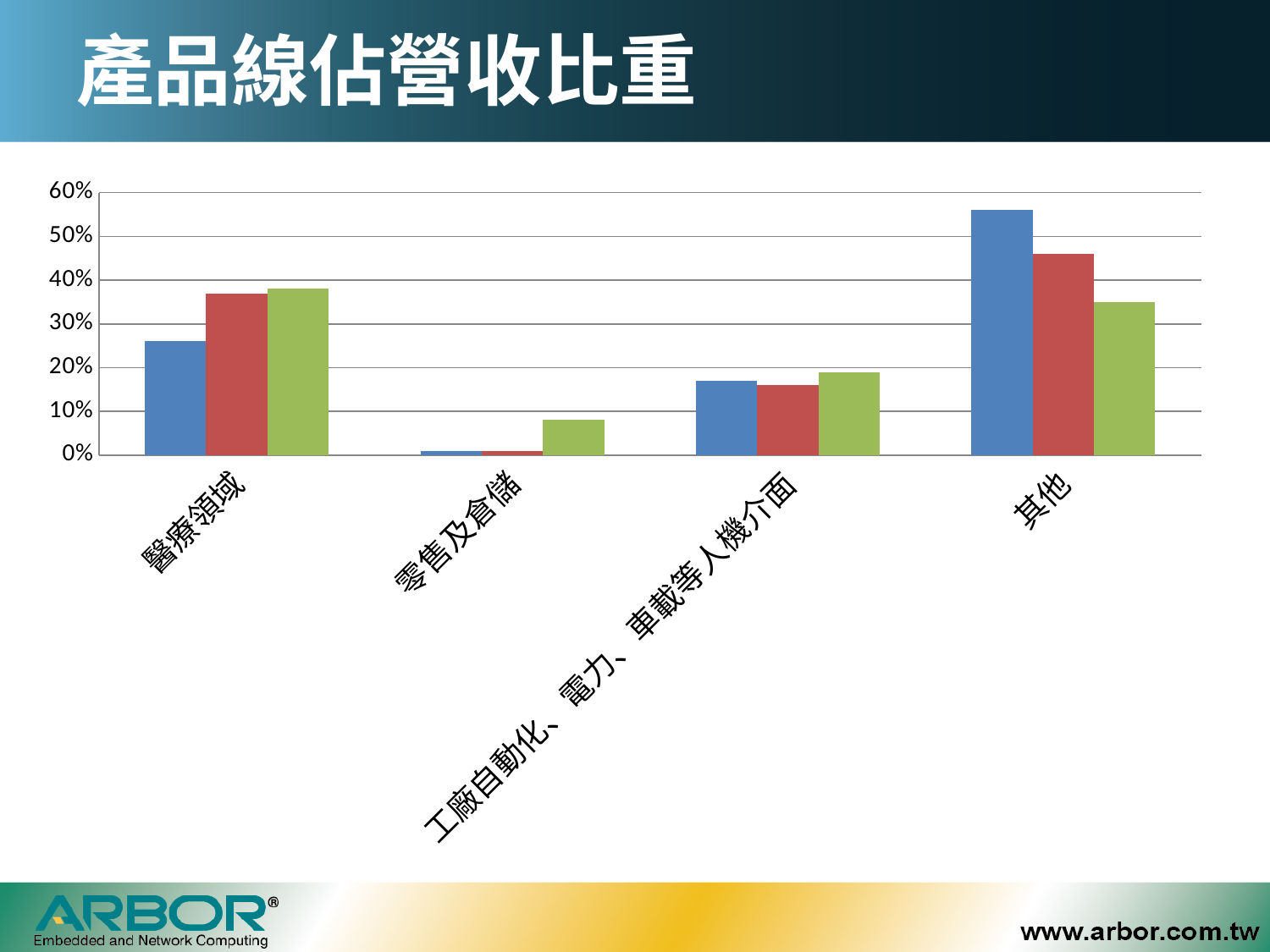
Which category has the lowest bars overall? 零售及倉儲 How many bars are plotted for each category in the chart? 3 What is the title of the chart on the slide? 產品線佔營收比重 Is the value of the green bar for 零售及倉儲 greater or less than 10%? less How many categories are shown on the x axis of the chart? 4 Is the value of the blue bar for 醫療領域 greater or less than 30%? less Which category has the tallest blue bar? 其他 Is the value of the blue bar for 其他 greater or less than 50%? greater What kind of chart is shown on the slide? Bar chart For 醫療領域, which is larger: the blue bar or the green bar? The green bar For 其他, which is larger: the blue bar or the red bar? The blue bar